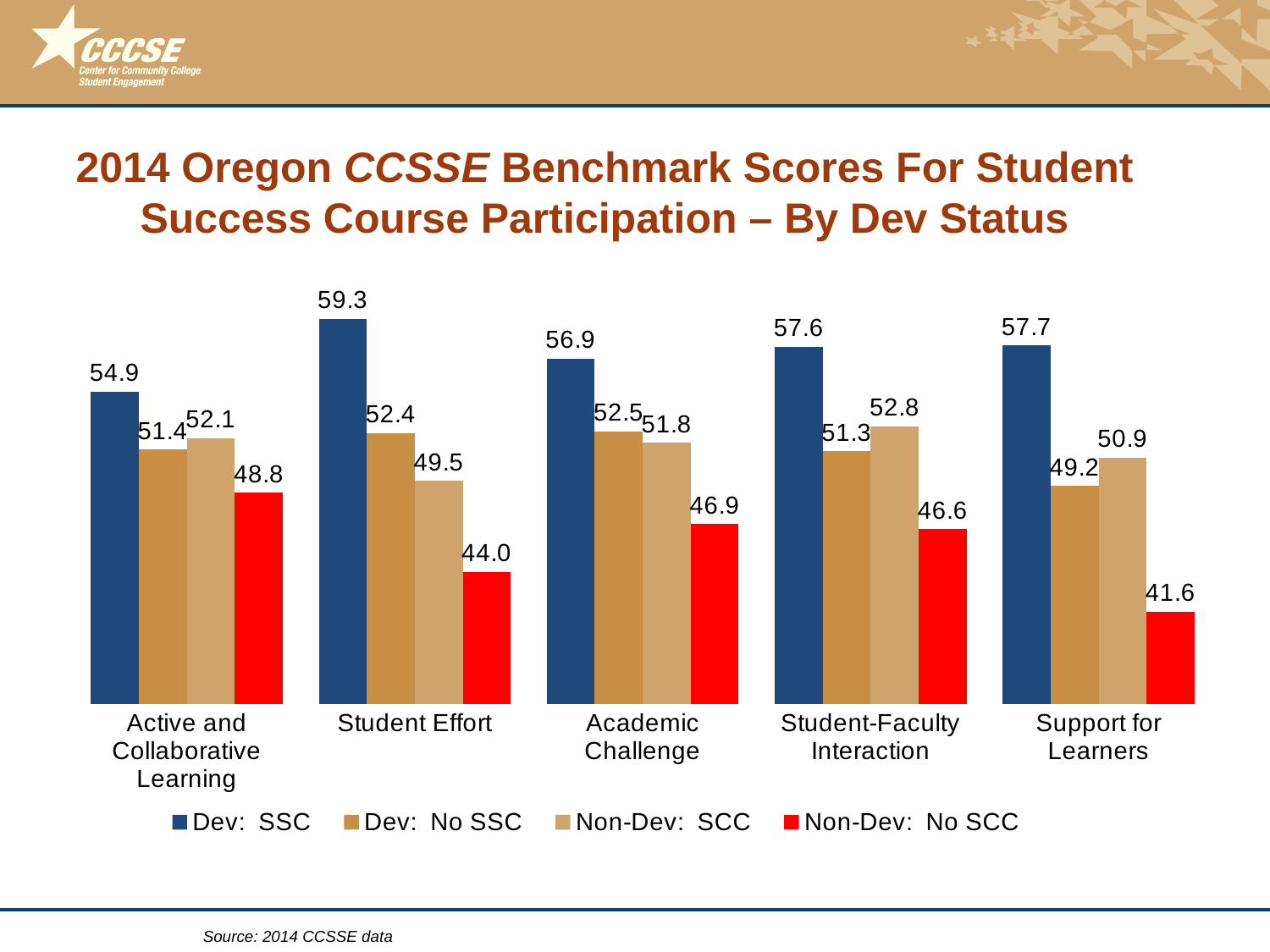
What is the Non-Dev: SCC value for Student-Faculty Interaction? 52.8 What is the Non-Dev: No SCC value for Support for Learners? 41.6 What kind of chart is shown on the slide? Bar chart Which series is shown in red? Non-Dev: No SCC Which category has the highest Dev: SSC value? Student Effort How many benchmark categories are shown on the x axis? 5 What is the Dev: SSC value for Student Effort? 59.3 How many series does the legend list? 4 What is the Dev: No SSC value for Academic Challenge? 52.5 What is the difference between the Dev: SSC and Non-Dev: No SCC values for Support for Learners? 16.1 Which is larger for Active and Collaborative Learning: Dev: No SSC or Non-Dev: SCC? Non-Dev: SCC Which category has the lowest Non-Dev: No SCC value? Support for Learners